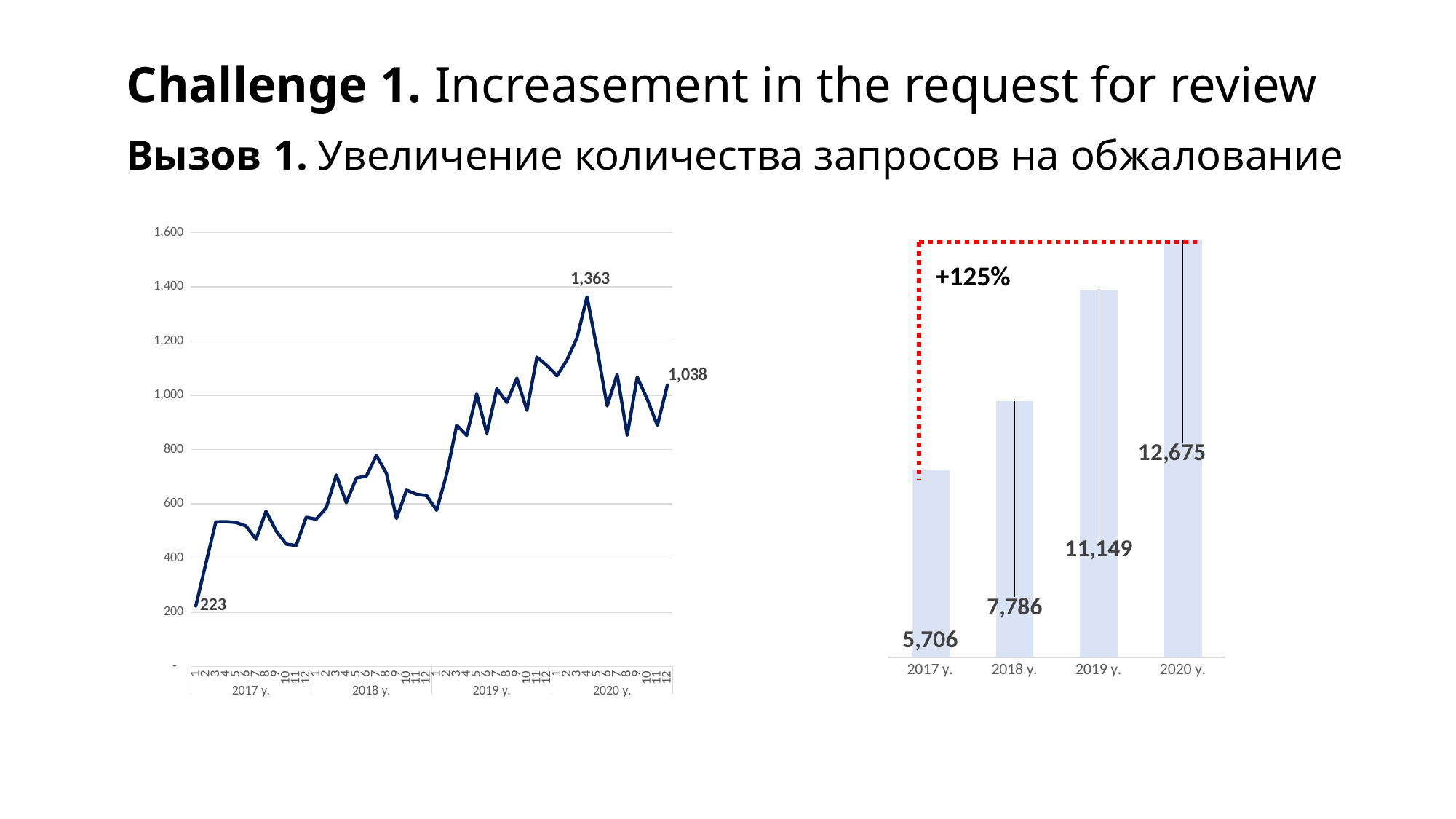
In the line chart on the left, what is the highest labelled value? 1,363 In the line chart on the left, what is the value labelled at the last point (month 12 of 2020 y.)? 1,038 In the bar chart on the right, what is the difference between the values for 2020 y. and 2017 y.? 6,969 In the bar chart on the right, what is the value for 2020 y.? 12,675 What kind of chart is the chart on the left? line chart What kind of chart is the chart on the right? bar chart In the bar chart on the right, what is the value for 2018 y.? 7,786 In the bar chart on the right, which year has the lowest value? 2017 y. In the bar chart on the right, do the values rise or fall from 2017 y. to 2020 y.? rise In the bar chart on the right, what is the value for 2017 y.? 5,706 In the bar chart on the right, which year has the highest value? 2020 y. In the bar chart on the right, how many years are shown? 4